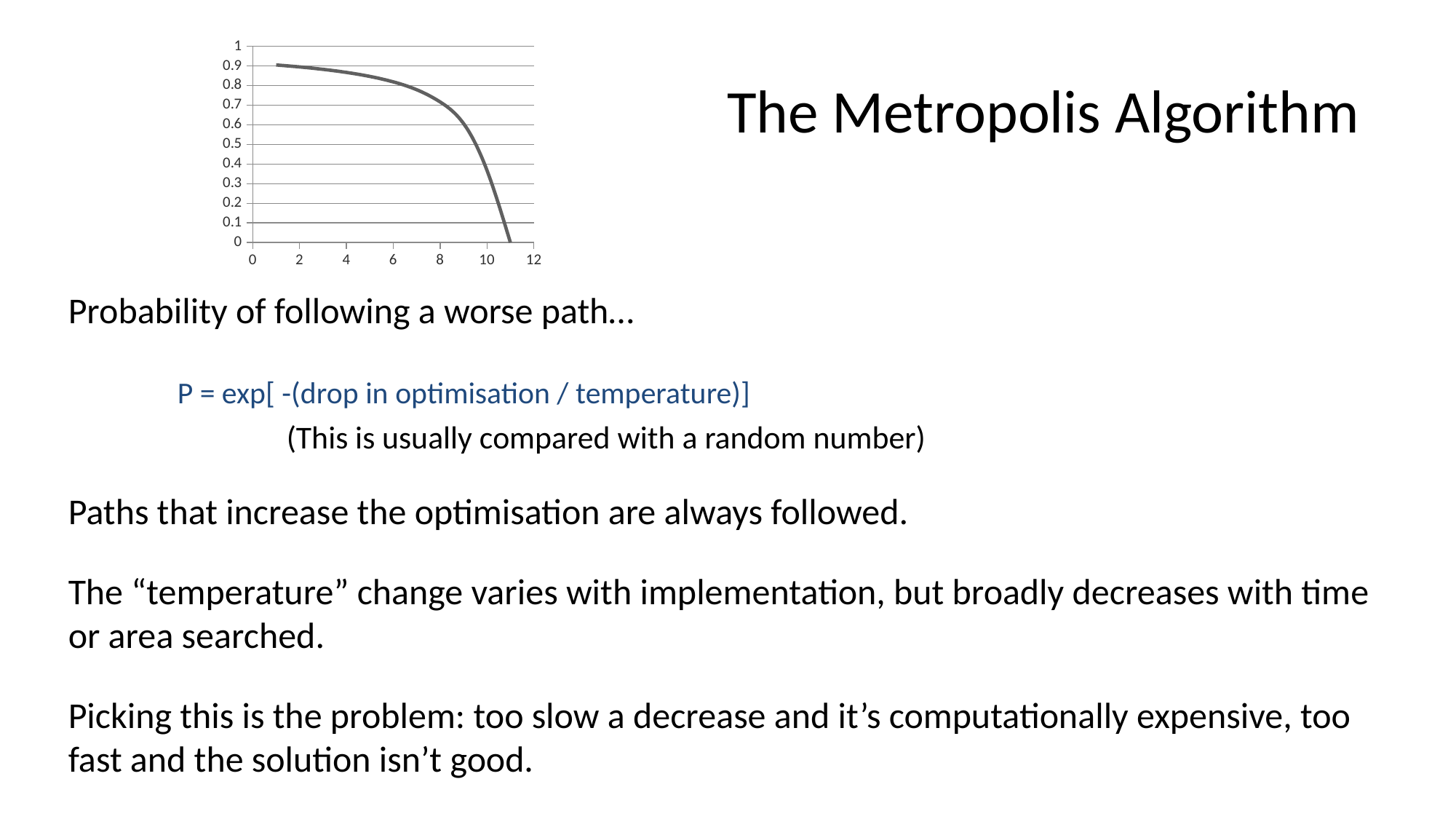
What kind of chart is shown on the slide? line chart Is the plotted value at x = 8 greater or less than 0.9? less Is the plotted value at x = 2 larger or smaller than the value at x = 10? larger How many lines are plotted on the chart? 1 What is the highest value shown on the chart's x axis? 12 Is the plotted value at x = 6 greater or less than 0.5? greater What is the highest value shown on the chart's y axis? 1 Is the plotted value at x = 10 greater or less than 0.7? less Do the plotted values rise or fall as the x axis increases? fall